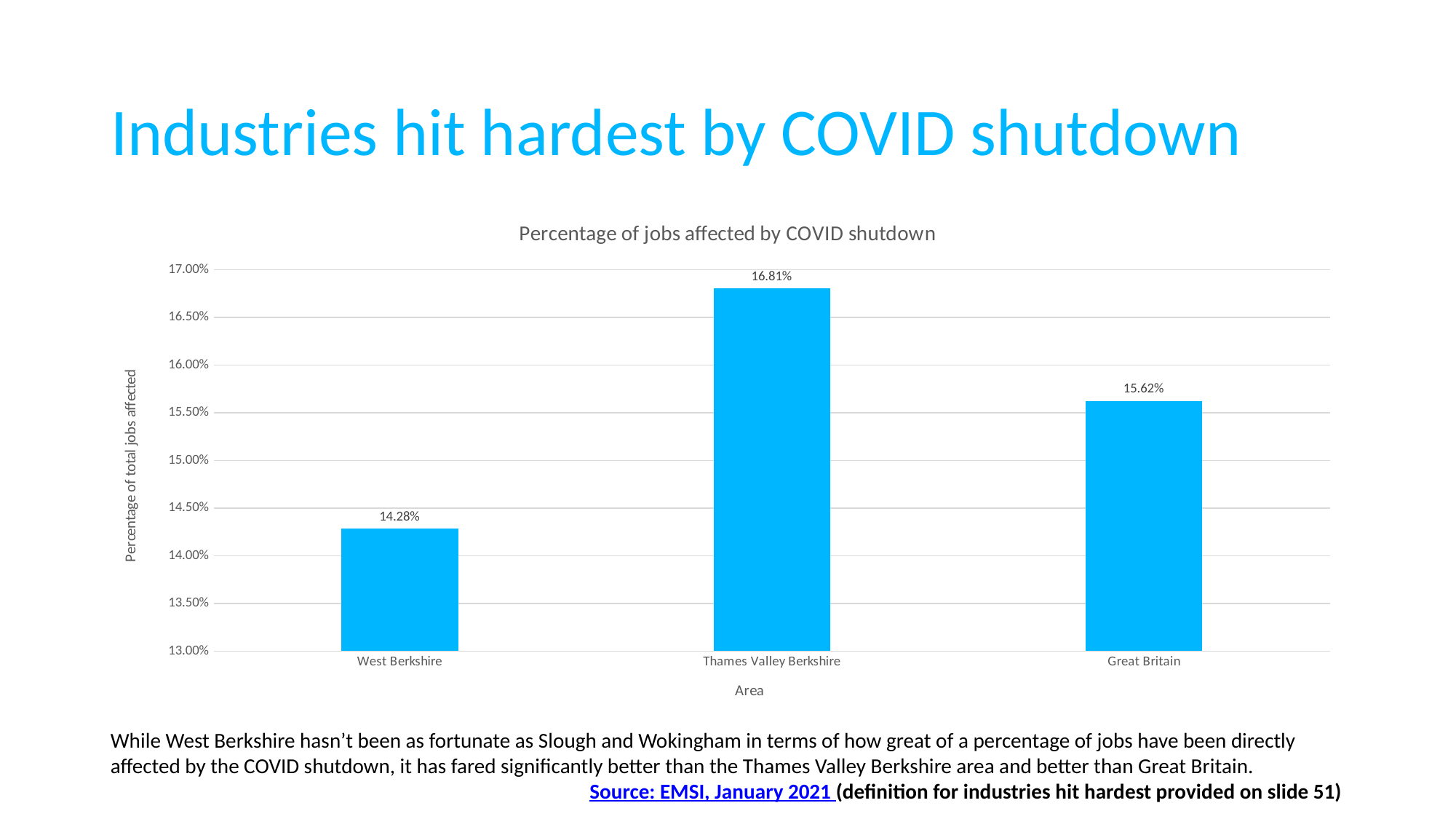
What is the difference in percentage points between Thames Valley Berkshire and West Berkshire? 2.53 What is the percentage of jobs affected by COVID shutdown for Great Britain? 15.62% What is the difference in percentage points between Great Britain and West Berkshire? 1.34 How many areas are shown in the chart? 3 Which has a higher percentage of jobs affected: Great Britain or West Berkshire? Great Britain Is the value for Great Britain greater or less than 16.00%? less What is the percentage of jobs affected by COVID shutdown for West Berkshire? 14.28% What is the percentage of jobs affected by COVID shutdown for Thames Valley Berkshire? 16.81% Which area has the highest percentage of jobs affected by COVID shutdown? Thames Valley Berkshire What type of chart is shown on the slide? Bar chart Which area has the lowest percentage of jobs affected by COVID shutdown? West Berkshire What is the title of the chart? Percentage of jobs affected by COVID shutdown